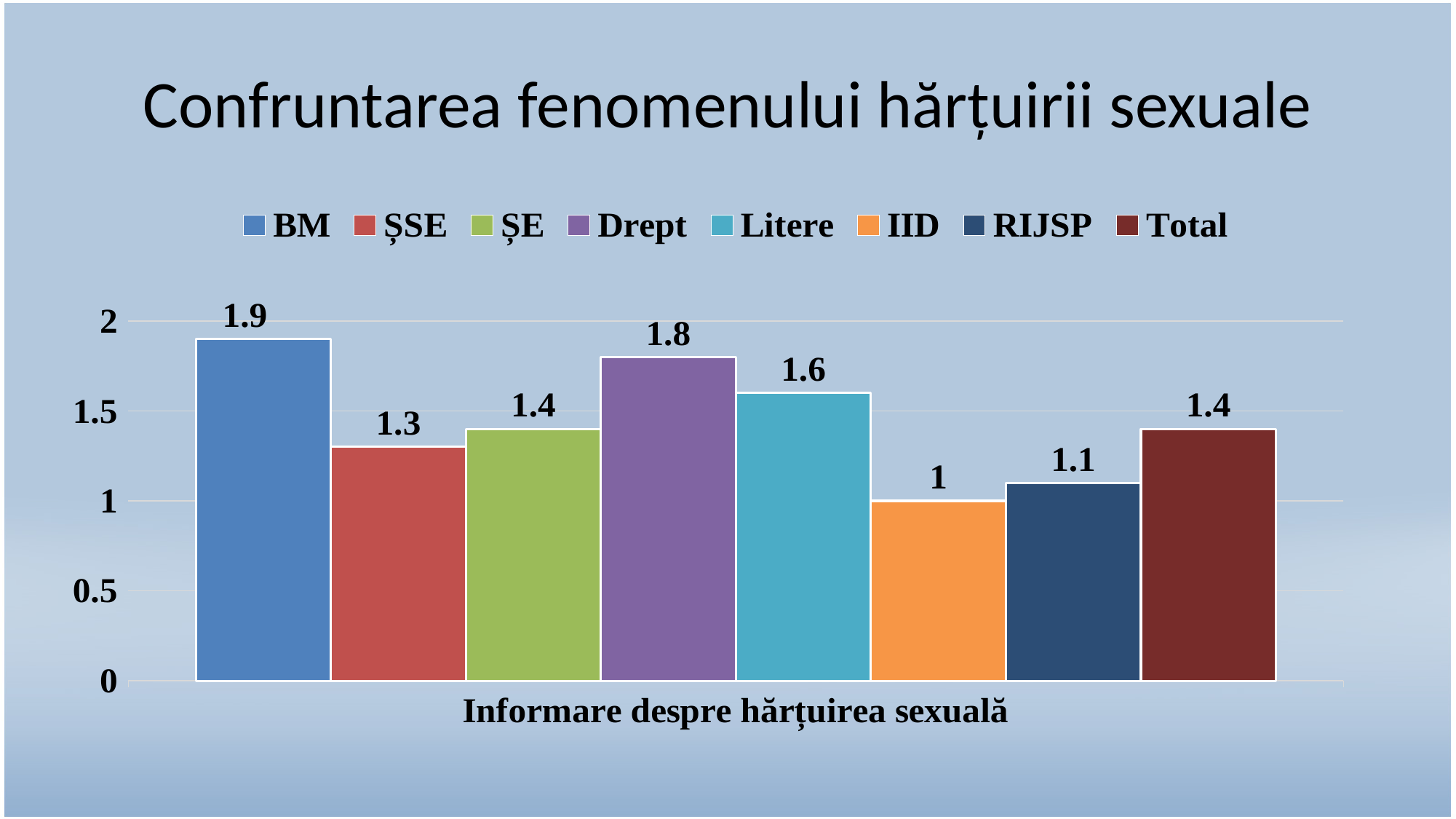
Which series has the lowest value? IID What is the difference between the values for BM and ȘSE? 0.6 What is the value for IID? 1 How many series does the legend list? 8 What is the value for Total? 1.4 Which is larger, the value for Drept or the value for RIJSP? Drept What is the label on the x axis of the chart? Informare despre hărțuirea sexuală Is the value for ȘE greater or less than 1.5? less What kind of chart is shown on the slide? bar chart Which series has the highest value? BM What is the value for Litere? 1.6 What is the value for BM? 1.9